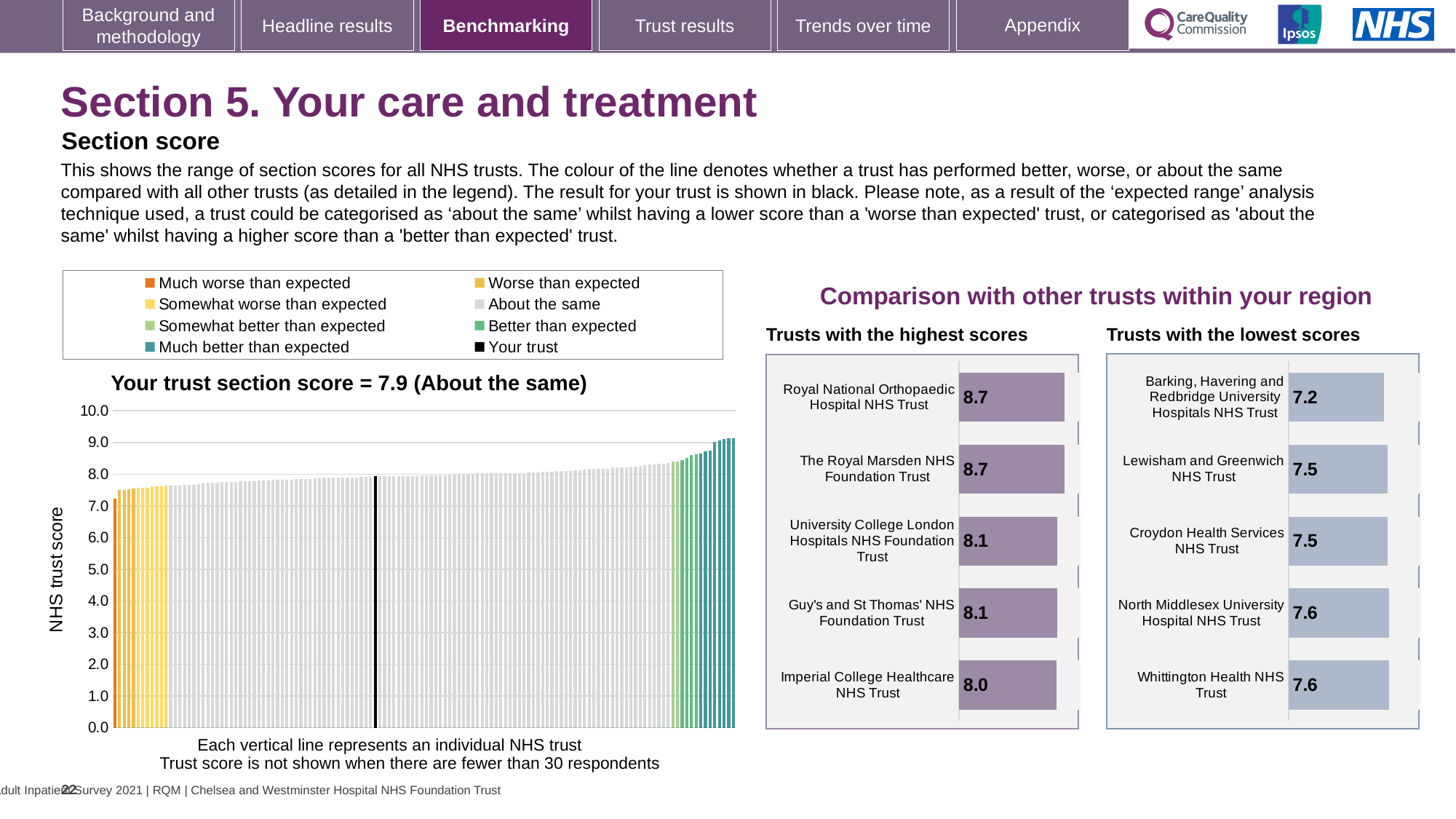
On the 'Your trust section score' chart, what is the highest value shown on the vertical axis? 10.0 On the 'Trusts with the lowest scores' chart, which has the larger score, Lewisham and Greenwich NHS Trust or Whittington Health NHS Trust? Whittington Health NHS Trust On the 'Trusts with the highest scores' chart, what is the difference between the scores of The Royal Marsden NHS Foundation Trust and Imperial College Healthcare NHS Trust? 0.7 On the 'Trusts with the lowest scores' chart, how many trusts are shown? 5 On the 'Trusts with the lowest scores' chart, which trust has the lowest score? Barking, Havering and Redbridge University Hospitals NHS Trust On the 'Your trust section score' chart, do the trust scores rise or fall from left to right? rise On the 'Trusts with the highest scores' chart, which trust has the lowest score? Imperial College Healthcare NHS Trust On the 'Your trust section score' chart, what kind of chart is shown? bar chart On the 'Trusts with the highest scores' chart, what is the score for Imperial College Healthcare NHS Trust? 8.0 On the 'Your trust section score' chart, how many entries does the legend list? 8 On the 'Your trust section score' chart, is the value for the rightmost trust greater or less than 8.0? greater On the 'Your trust section score' chart, what is the section score for your trust? 7.9